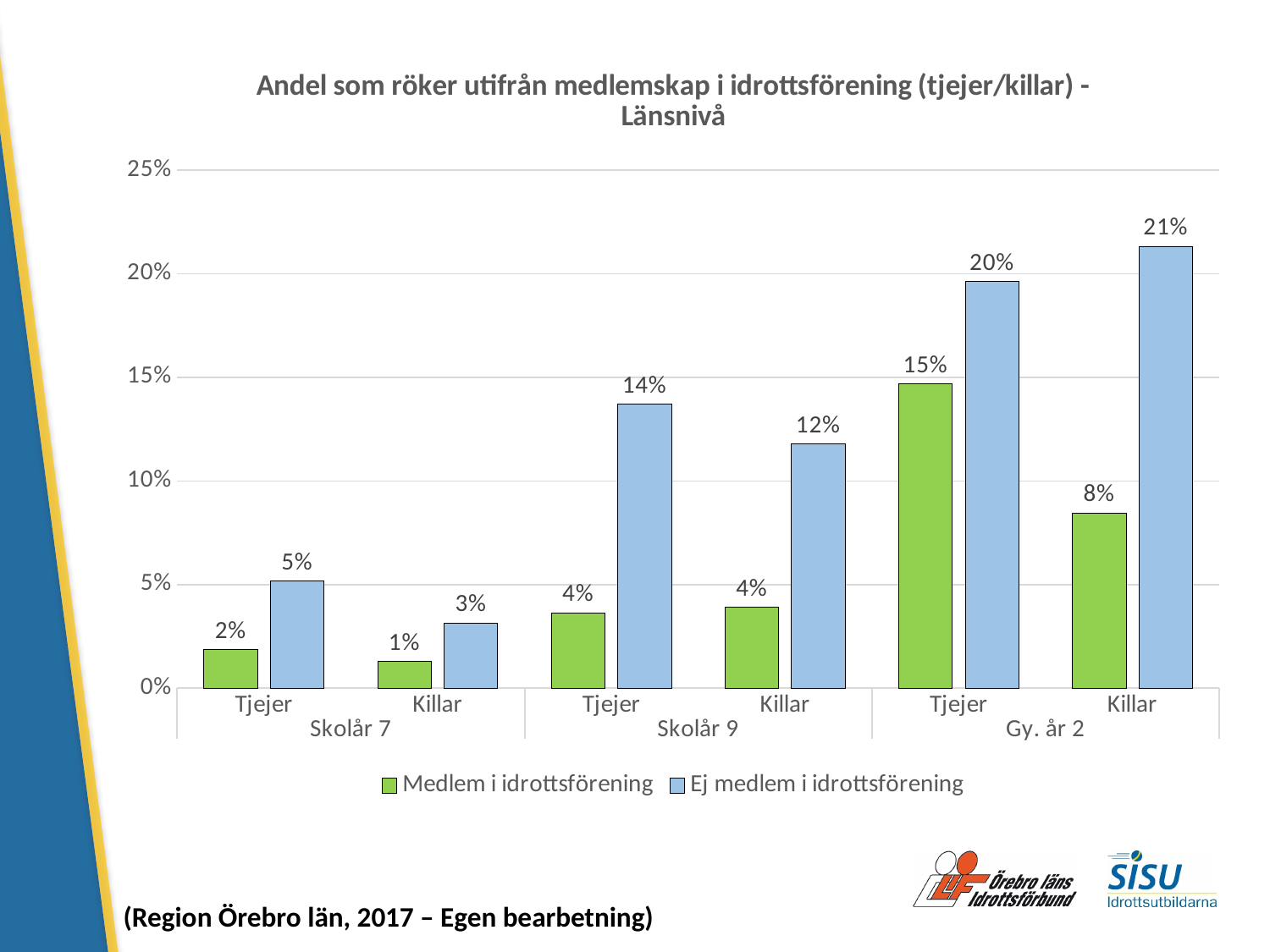
Which group has the lowest value for 'Medlem i idrottsförening'? Killar, Skolår 7 How many groups (category bars pairs) are shown on the x axis? 6 Is the value for 'Ej medlem i idrottsförening' for Tjejer in Gy. år 2 greater or less than 15%? greater For Tjejer in Skolår 9, which is larger: 'Medlem i idrottsförening' or 'Ej medlem i idrottsförening'? Ej medlem i idrottsförening What is the value for 'Medlem i idrottsförening' for Tjejer in Gy. år 2? 15% What is the difference between 'Ej medlem i idrottsförening' and 'Medlem i idrottsförening' for Killar in Gy. år 2? 13% What kind of chart is shown on the slide? Bar chart What is the value for 'Ej medlem i idrottsförening' for Killar in Skolår 9? 12% Which group has the highest value for 'Ej medlem i idrottsförening'? Killar, Gy. år 2 Which colour represents 'Medlem i idrottsförening' in the chart? Green How many series does the legend list? 2 What is the value for 'Medlem i idrottsförening' for Killar in Skolår 7? 1%